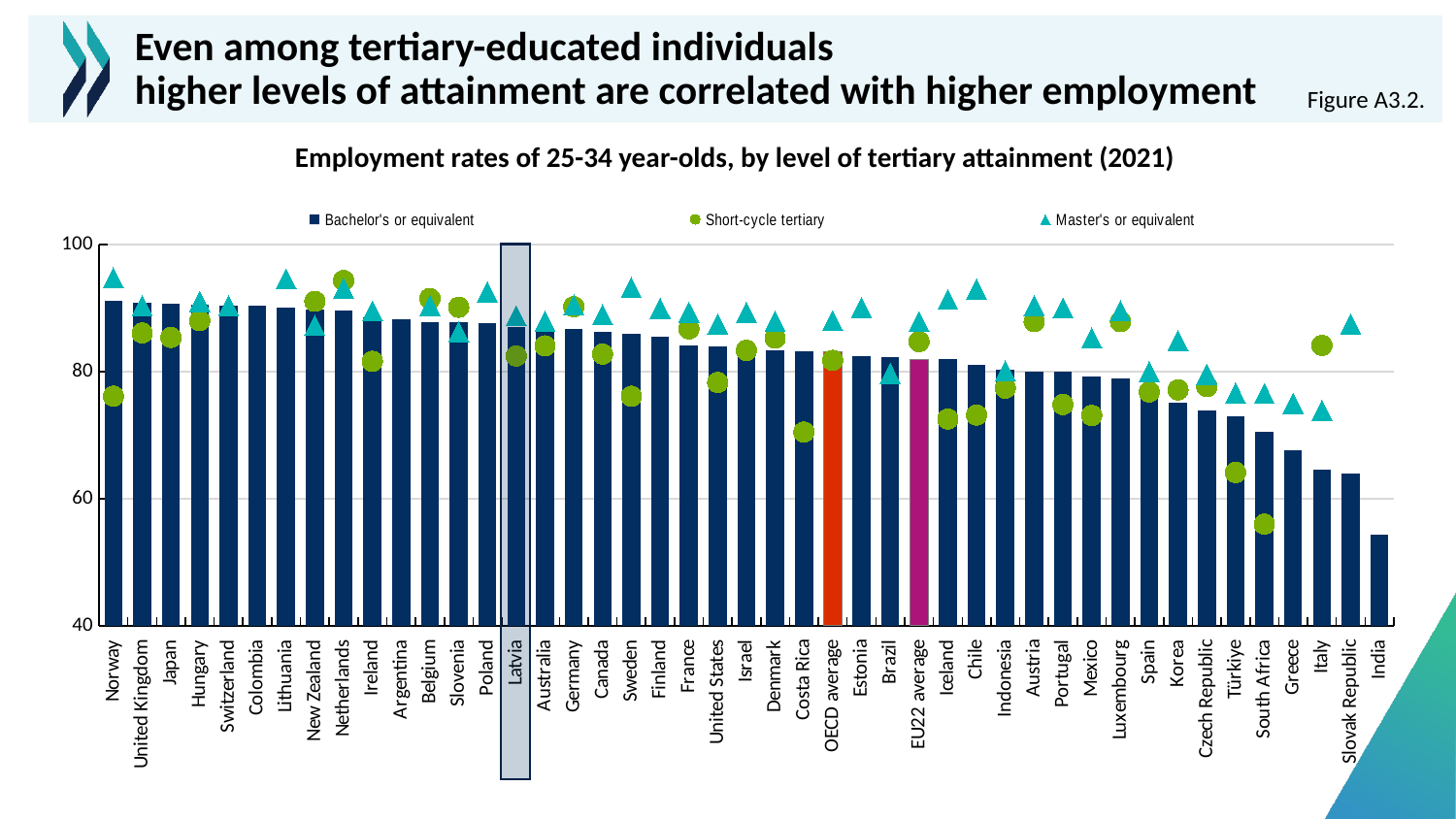
Is the Short-cycle tertiary value for Netherlands greater or less than 80? greater How many countries/categories are shown along the x axis? 45 Is the Bachelor's or equivalent value for India greater or less than 60? less For Norway, which is larger: the Bachelor's or equivalent value or the Short-cycle tertiary value? Bachelor's or equivalent Is the Short-cycle tertiary value for South Africa greater or less than 60? less Which country is highlighted with a box on the chart? Latvia How many series does the legend list? 3 What kind of chart is shown on the slide? Bar chart (with overlaid markers) Do the Bachelor's or equivalent values rise or fall moving from left to right along the x axis? fall Which category has the lowest value for Bachelor's or equivalent? India Which category has the highest value for Bachelor's or equivalent? Norway